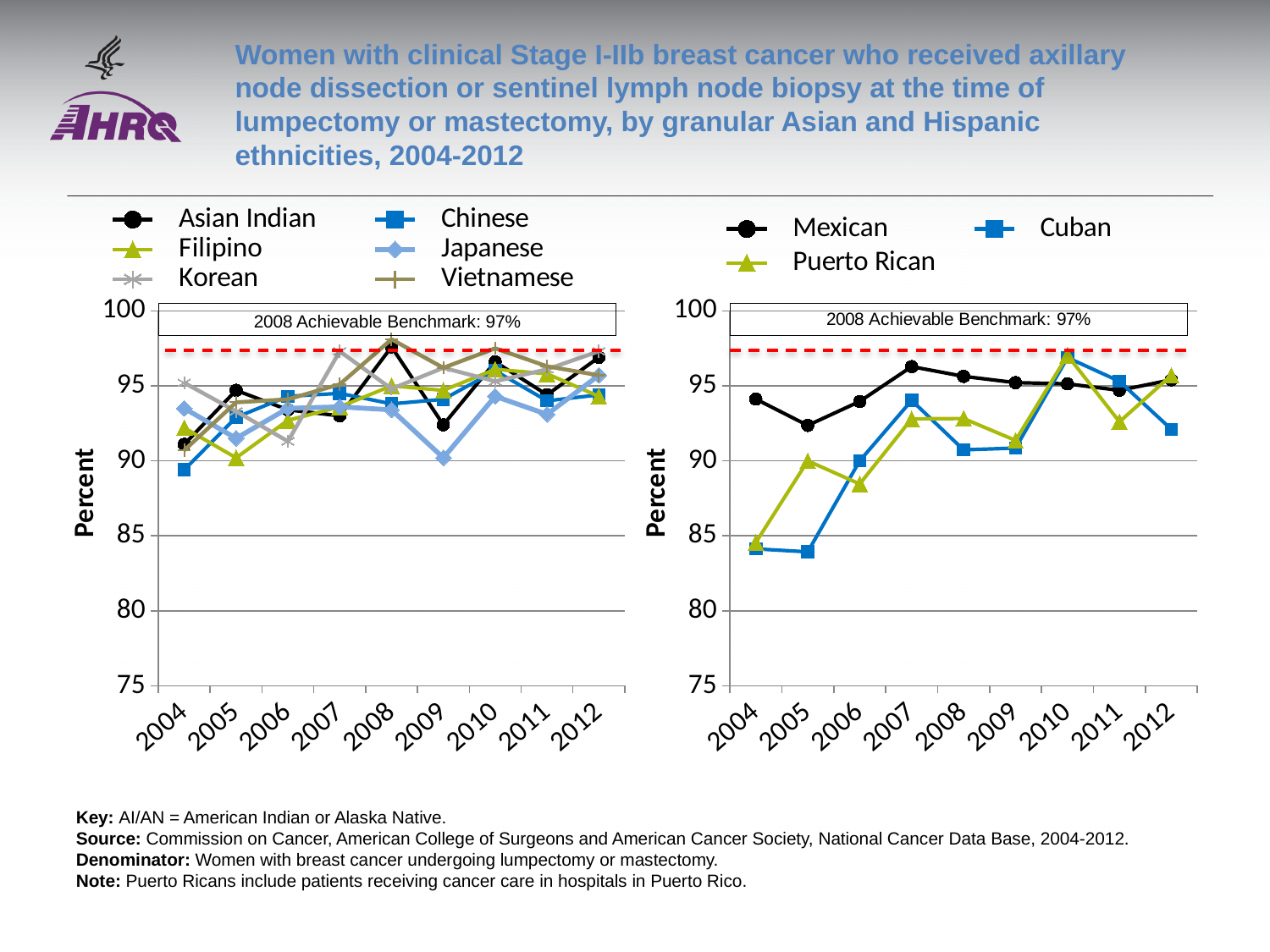
In the left chart, is the value for Vietnamese in 2008 greater or less than 95? greater In the right chart, did the value for Cuban generally rise or fall from 2004 to 2010? rise In the right chart, is the value for Mexican in 2007 greater or less than 95? greater How many series does the legend of the right chart (Hispanic ethnicities) list? 3 What kind of chart is the left chart showing Asian ethnicities? line chart How many series does the legend of the left chart (Asian ethnicities) list? 6 How many years are plotted along the x axis of the right chart? 9 In the right chart, which group had the lowest value in 2012? Cuban In the right chart, is the value for Cuban in 2004 greater or less than 85? less In the right chart, which group had the highest value in 2004? Mexican What is the 2008 Achievable Benchmark shown on both charts? 97%